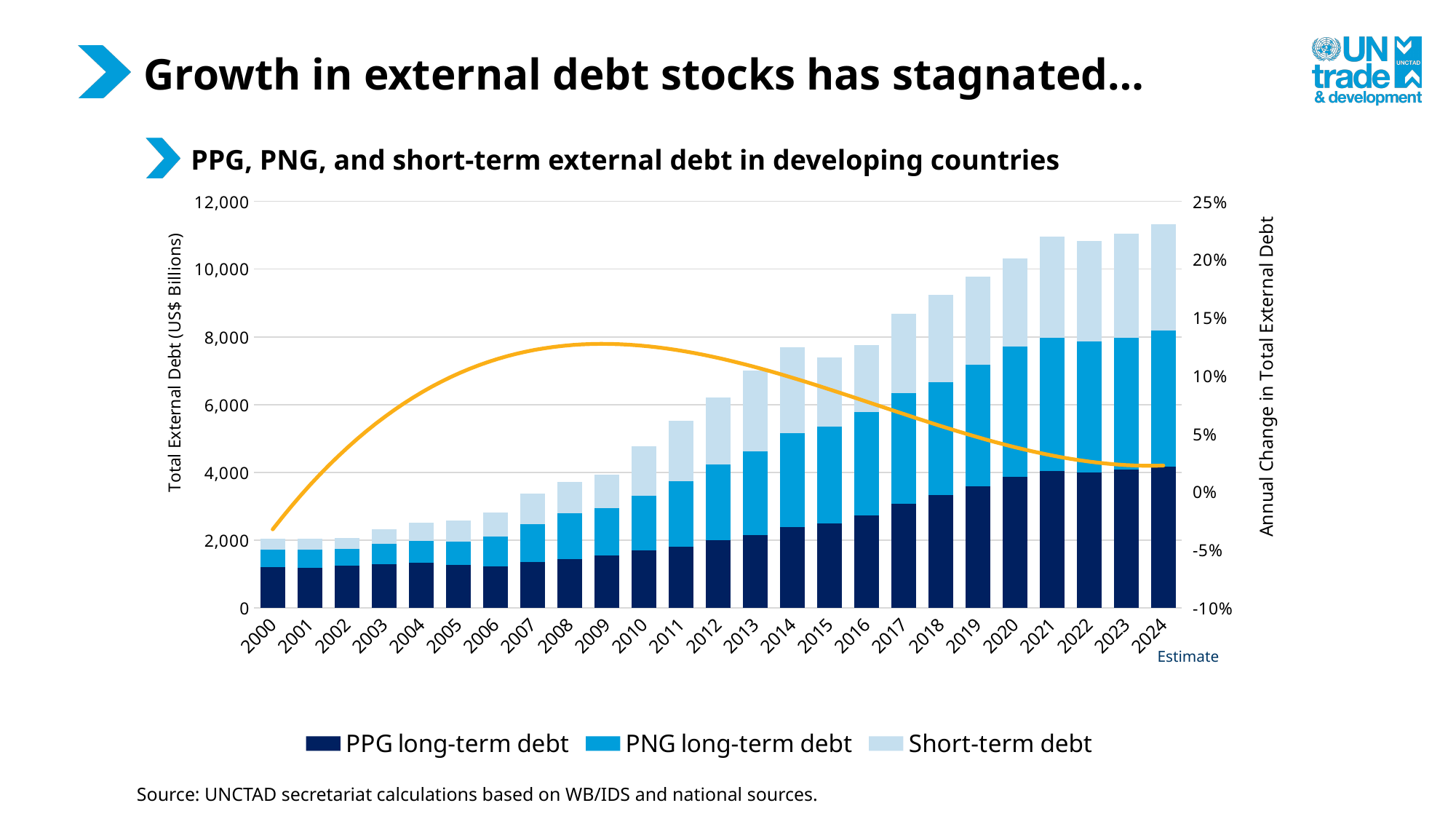
How many years are shown along the x axis of the chart? 25 Do the total external debt stocks generally rise or fall from 2000 to 2024? rise Which year has the highest total external debt stock? 2024 What kind of chart is shown on the slide? Stacked bar chart with a line Is the total external debt for 2024 greater or less than 10,000? greater Is the total external debt for 2017 greater or less than 8,000? greater What is the label of the right-hand vertical axis? Annual Change in Total External Debt What is the title of the chart? PPG, PNG, and short-term external debt in developing countries Is the total external debt for 2010 greater or less than 6,000? less Which year has the larger total external debt, 2019 or 2020? 2020 How many series does the legend list? 3